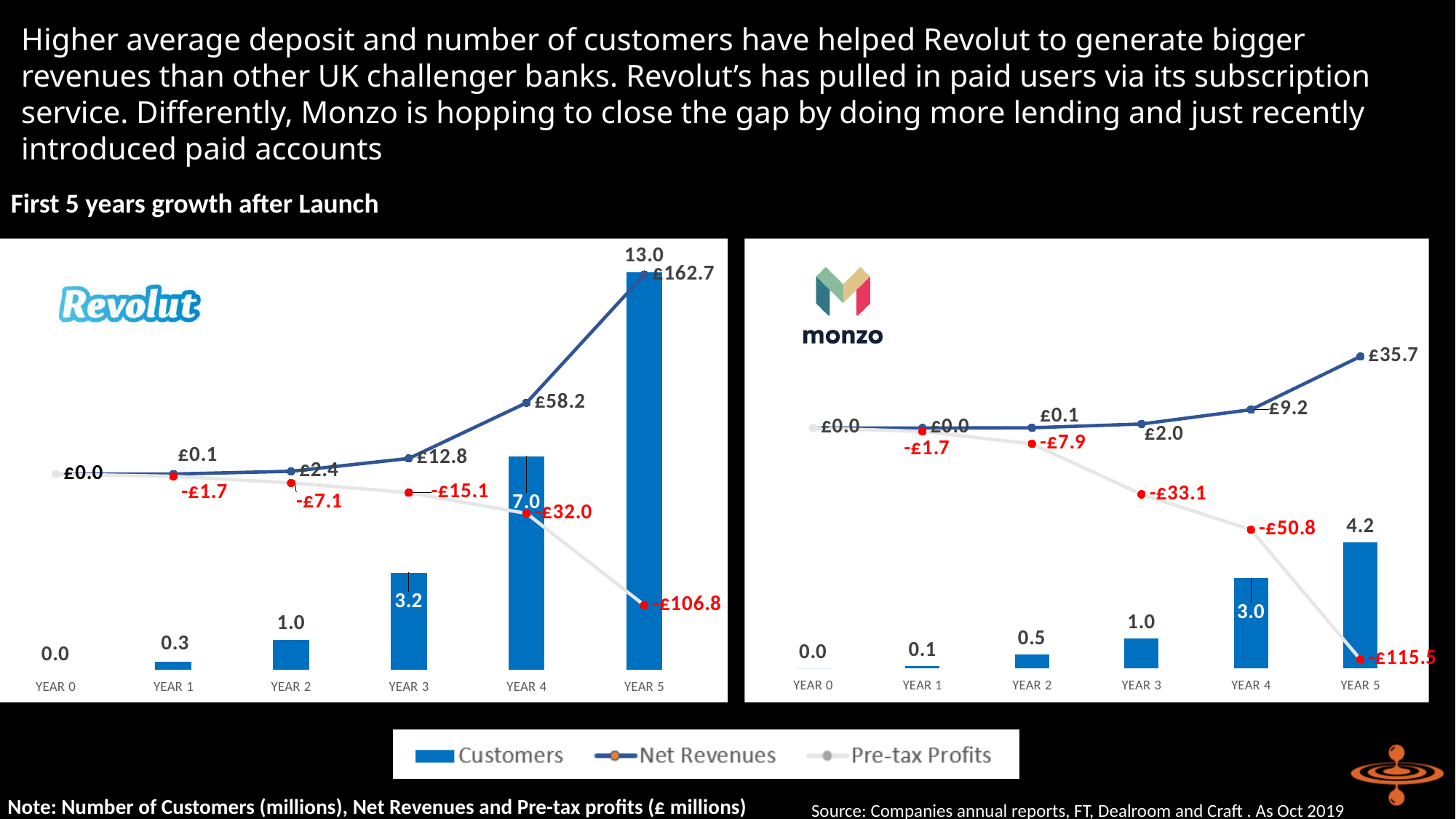
What is the difference between Revolut's and Monzo's net revenues in Year 5? £127.0 Which series is shown as bars in the charts? Customers In Year 4, which bank has more customers, Revolut or Monzo? Revolut In the Revolut chart, do net revenues rise or fall from Year 0 to Year 5? Rise How many years are shown on the x axis of the Revolut chart? 6 In the Revolut chart, which year has the highest net revenues? Year 5 In the Revolut chart, what is the pre-tax profit in Year 4? -£32.0 In the Monzo chart, what is the pre-tax profit in Year 3? -£33.1 How many series does the legend list? 3 In the Monzo chart, what are the net revenues in Year 5? £35.7 In the Revolut chart, what is the number of customers in Year 5? 13.0 In the Monzo chart, which year has the lowest pre-tax profit? Year 5